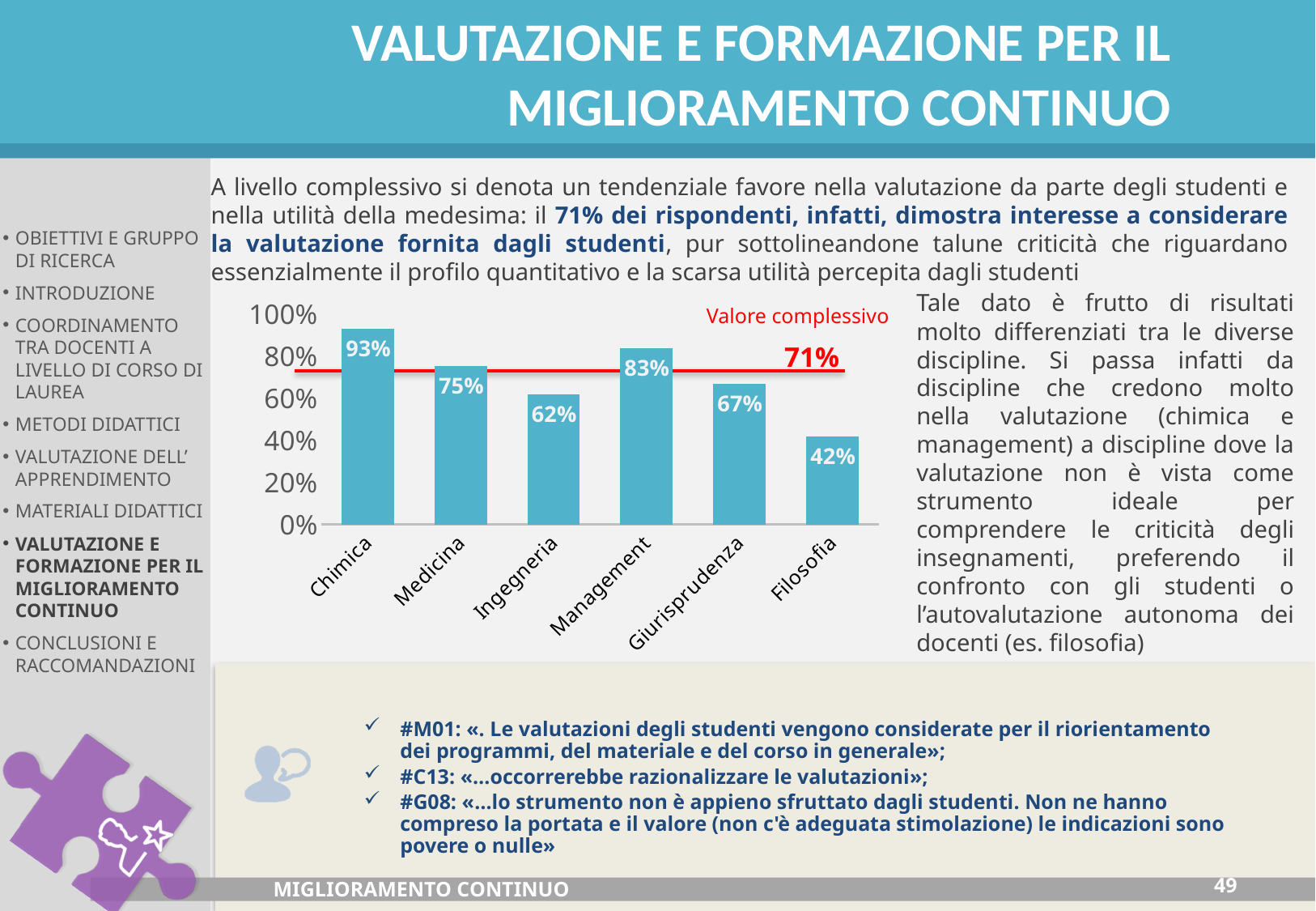
How many disciplines are shown on the x axis? 6 What is the value for Filosofia? 42% Which discipline has the lowest value? Filosofia Which discipline has the highest value? Chimica What kind of chart is shown? bar chart Is the value for Ingegneria greater or less than 80%? less What value does the red horizontal line labelled 'Valore complessivo' mark? 71% What is the difference between the values for Chimica and Filosofia? 51% What is the value for Chimica? 93% Which is larger, the value for Medicina or the value for Giurisprudenza? Medicina What is the difference between the values for Medicina and Ingegneria? 13% What is the value for Management? 83%